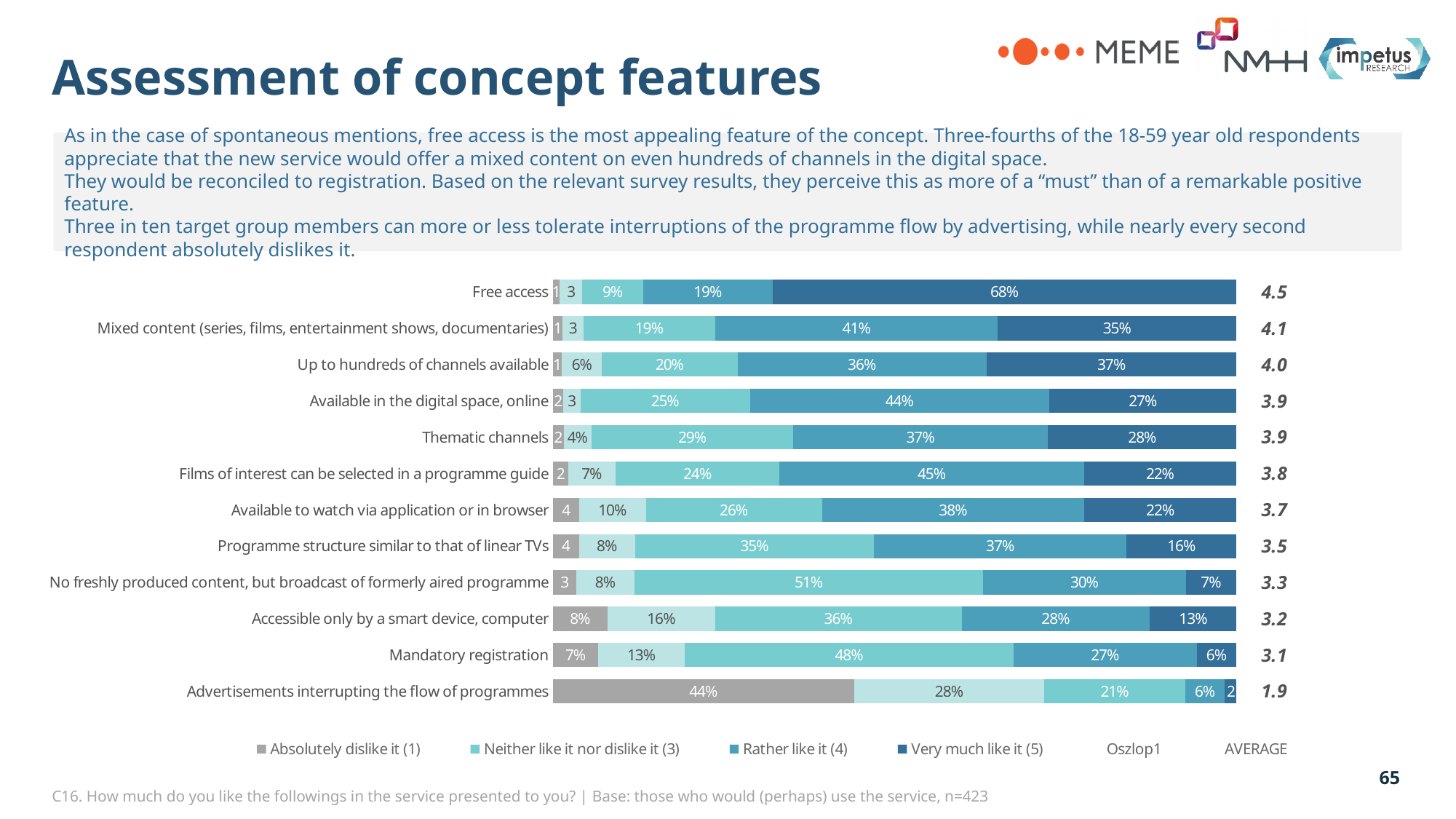
What percentage of respondents answered "Very much like it (5)" for Free access? 68% How many concept features are listed in the chart? 12 What is the difference between the AVERAGE scores of Free access and Advertisements interrupting the flow of programmes? 2.6 What percentage answered "Neither like it nor dislike it (3)" for No freshly produced content, but broadcast of formerly aired programme? 51% What is the AVERAGE score shown for Mandatory registration? 3.1 Which feature has the highest AVERAGE score? Free access What is the title of the slide containing the chart? Assessment of concept features Which has a larger "Rather like it (4)" share: Mixed content (series, films, entertainment shows, documentaries) or Available in the digital space, online? Available in the digital space, online What share of respondents "Absolutely dislike" Advertisements interrupting the flow of programmes? 44% What type of chart is shown on the slide? Stacked bar chart What is the difference between the "Very much like it (5)" shares for Free access and Mixed content (series, films, entertainment shows, documentaries)? 33 percentage points Which feature has the lowest AVERAGE score? Advertisements interrupting the flow of programmes